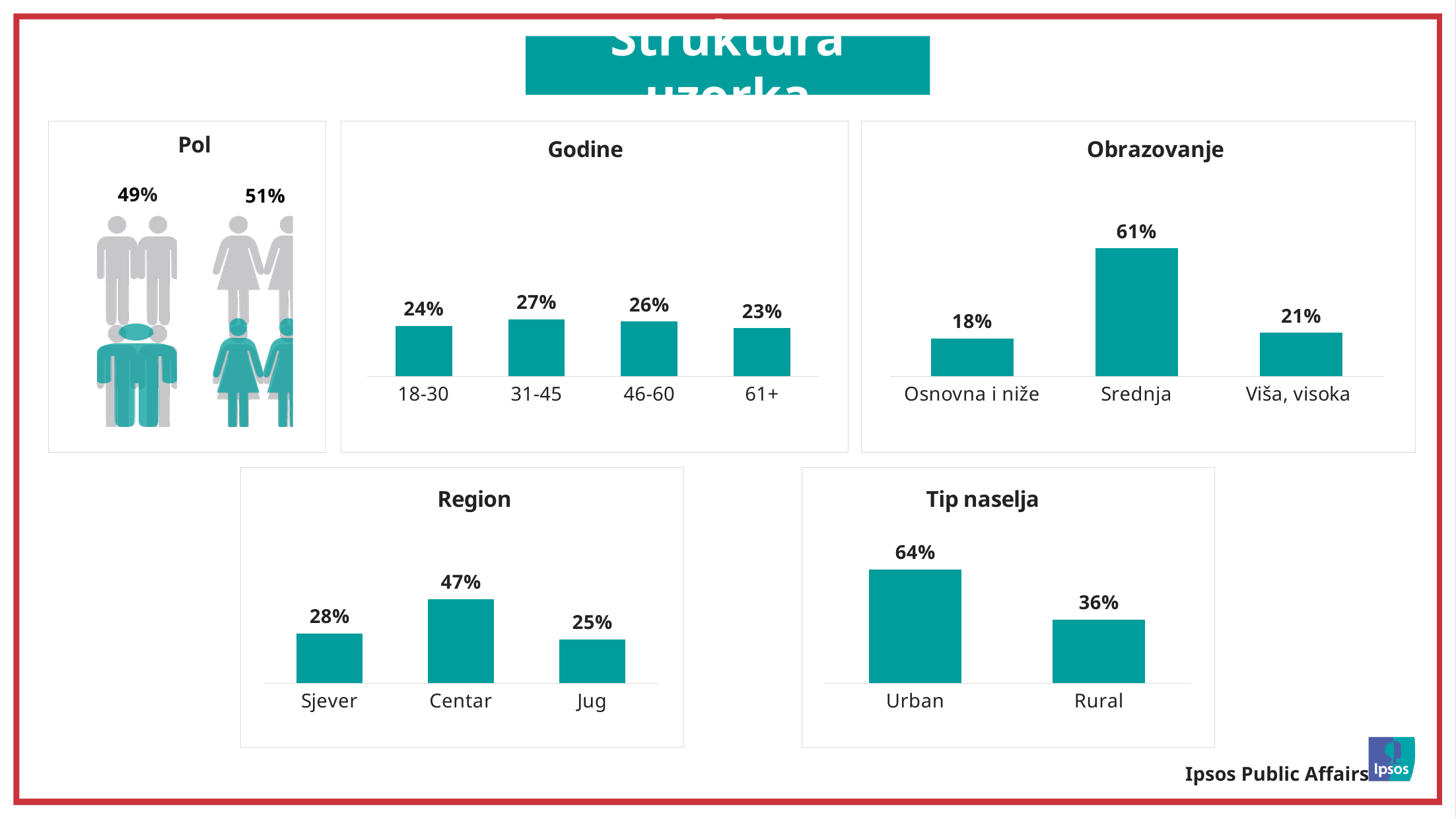
In the Obrazovanje chart, what is the difference between Srednja and Osnovna i niže? 43% In the Godine chart, which age group has the lowest value? 61+ In the Tip naselja chart, what is the difference between Urban and Rural? 28% In the Godine chart, what is the value for 31-45? 27% What kind of chart is the Region chart? bar chart In the Obrazovanje chart, what is the value for Srednja? 61% In the Godine chart, how many age categories are shown? 4 In the Obrazovanje chart, which category has the highest value? Srednja In the Region chart, what is the value for Centar? 47% In the Pol chart, what is the value shown for the female figures? 51% In the Region chart, which is larger, Sjever or Jug? Sjever In the Tip naselja chart, what is the value for Rural? 36%